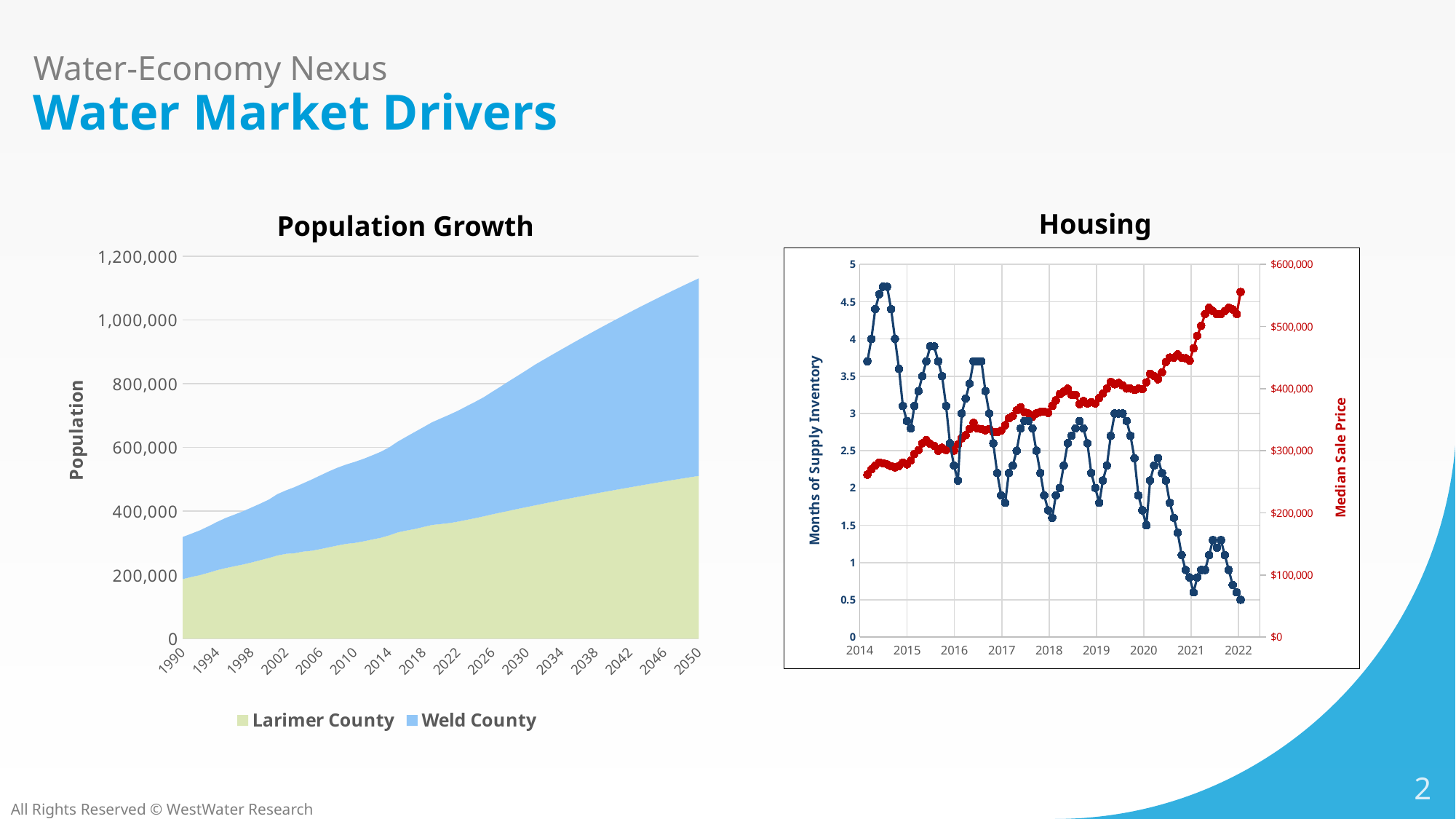
In the Population Growth chart, is the Larimer County value for 1990 greater or less than 400,000? less In the Housing chart, is the Median Sale Price at the start of 2014 greater or less than $300,000? less In the Population Growth chart, does the total population rise or fall from 1990 to 2050? Rise In the Population Growth chart, is the combined population of both counties in 2050 greater or less than 1,000,000? greater What kind of chart is the Housing chart? Line chart In the Housing chart, what label is on the right-hand vertical axis? Median Sale Price In the Population Growth chart, which two counties are shown in the legend? Larimer County and Weld County How many series does the legend of the Population Growth chart list? 2 In the Housing chart, does the Median Sale Price generally rise or fall from 2014 to 2022? Rise How many year labels are shown on the x axis of the Population Growth chart? 16 What kind of chart is the Population Growth chart? Stacked area chart